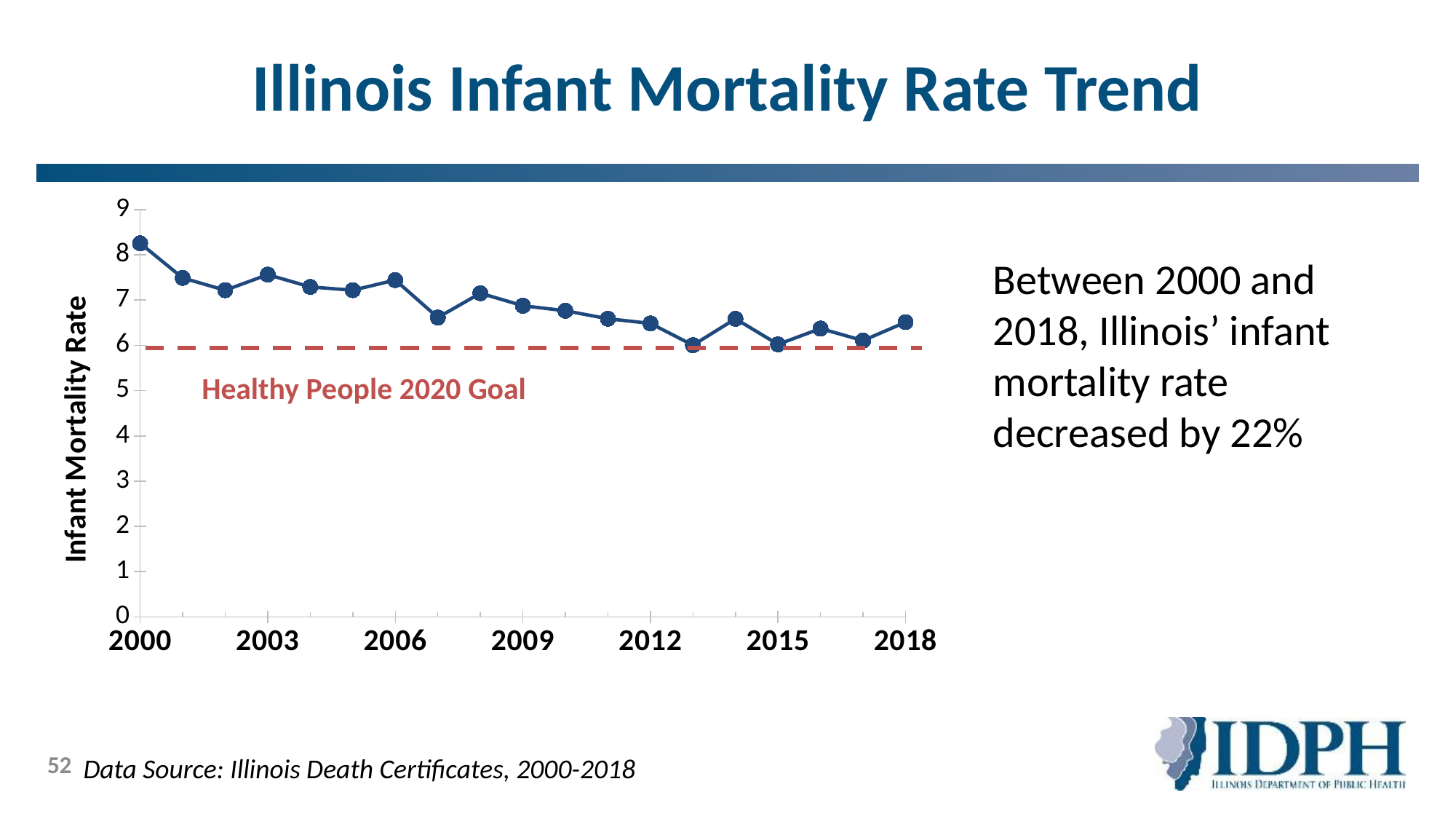
Which year has the higher infant mortality rate, 2000 or 2018? 2000 Is the infant mortality rate for 2007 greater or less than 7? less What is the title of the chart? Illinois Infant Mortality Rate Trend What does the red dashed line on the chart represent? Healthy People 2020 Goal Which year has the higher infant mortality rate, 2003 or 2007? 2003 Is the infant mortality rate for 2003 greater or less than 7? greater What kind of chart is shown on the slide? line chart Is the infant mortality rate for 2000 greater or less than 8? greater Which year has the highest infant mortality rate on the chart? 2000 Does the infant mortality rate generally rise or fall from 2000 to 2018? fall